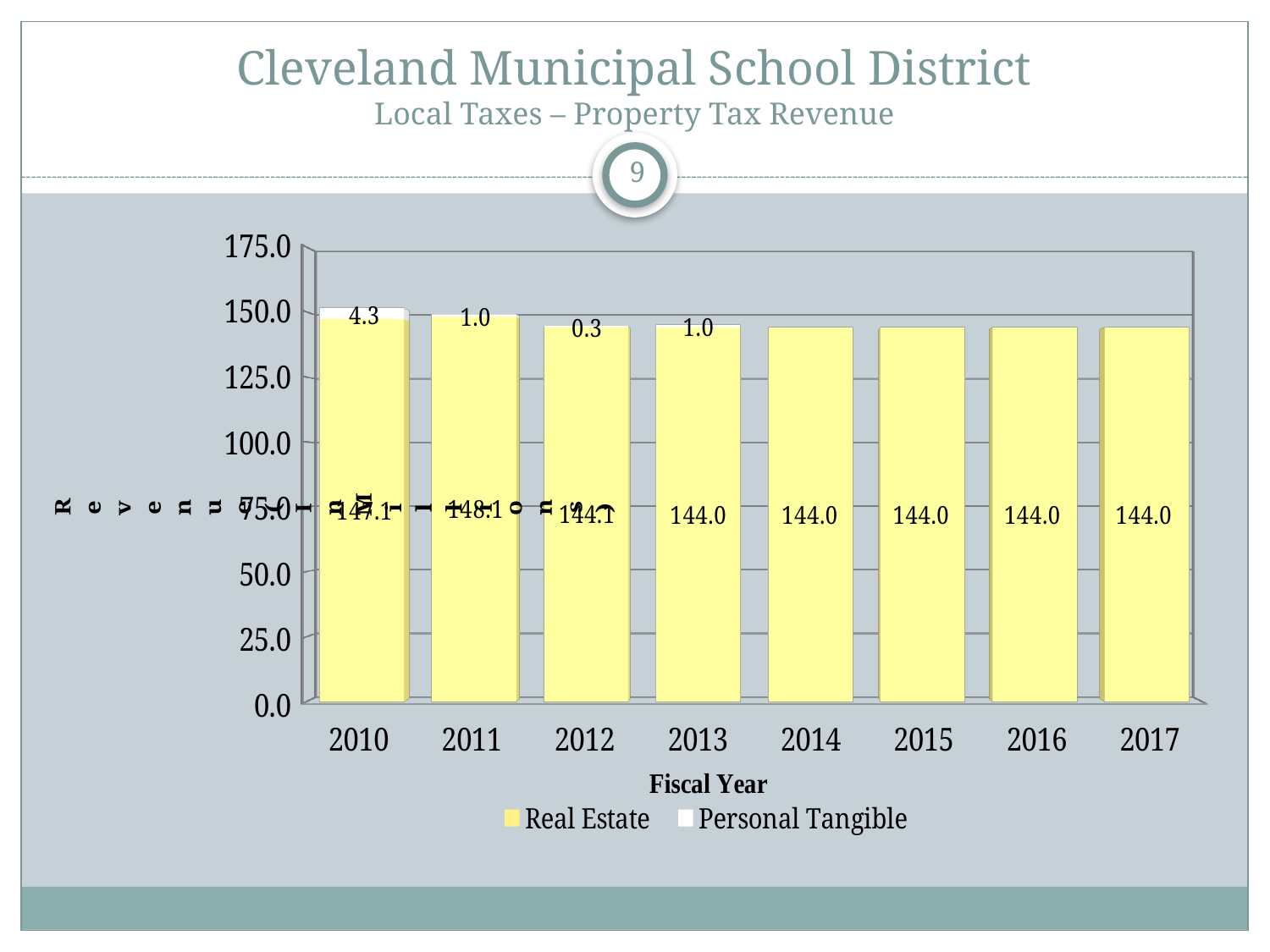
What kind of chart is shown on the slide? bar chart What is the Personal Tangible value for fiscal year 2010? 4.3 What is the Real Estate value for fiscal year 2012? 144.1 How many series does the legend list? 2 What is the total of the stacked bar for fiscal year 2013? 145.0 What is the difference between the Personal Tangible values for 2010 and 2013? 3.3 How many fiscal years are shown on the x axis? 8 What is the Real Estate value for fiscal year 2014? 144.0 Which fiscal year has the highest Personal Tangible value? 2010 What is the Personal Tangible value for fiscal year 2012? 0.3 Is the Real Estate value for 2016 greater or less than 150.0? less Which fiscal year has the highest Real Estate value? 2011